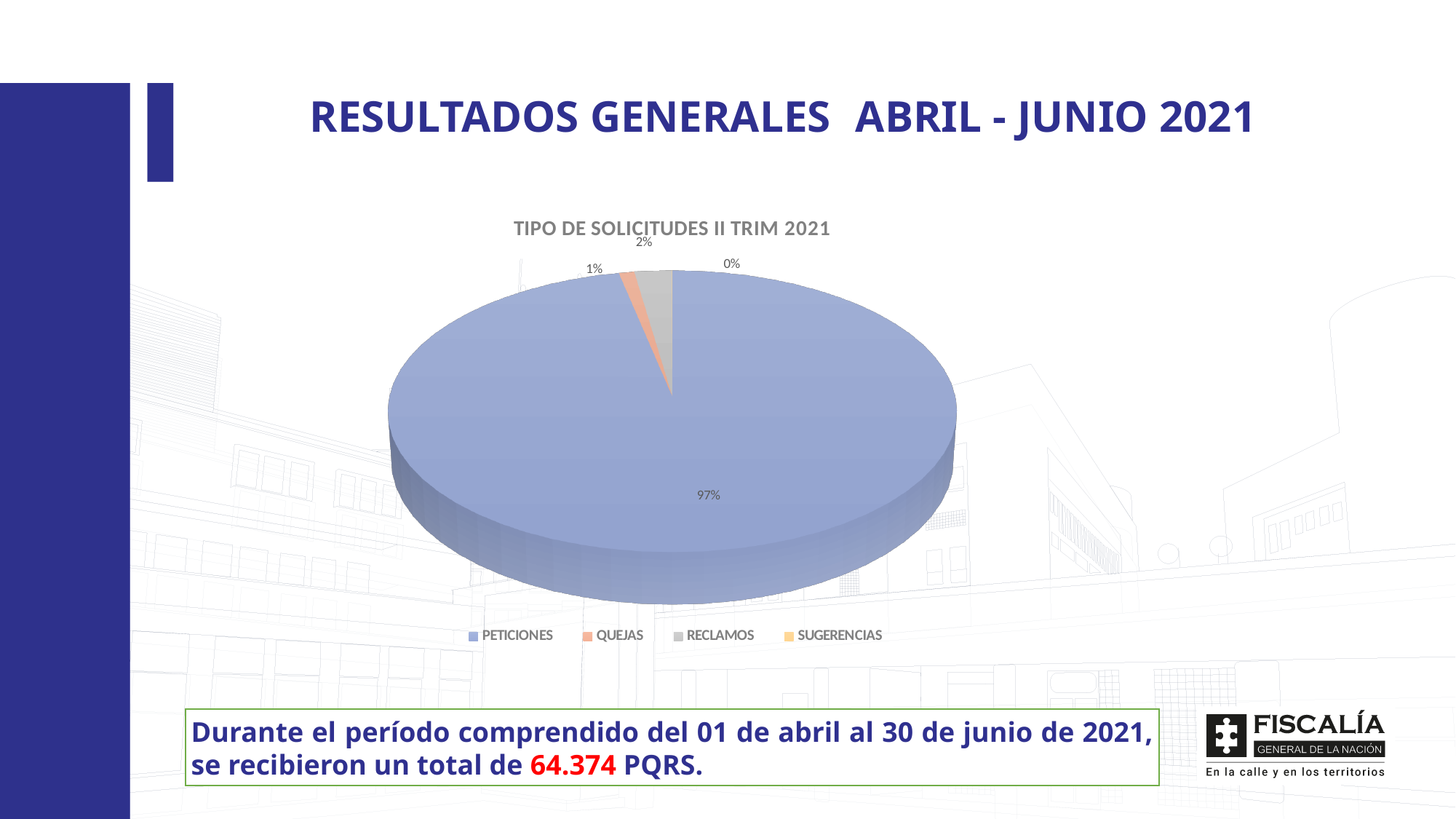
What colour is the PETICIONES slice in the pie chart? Blue What kind of chart is shown on the slide? Pie chart What percentage is shown for SUGERENCIAS? 0% What share of the pie does PETICIONES represent? 97% What is the title of the chart? TIPO DE SOLICITUDES II TRIM 2021 What percentage is shown for QUEJAS? 1% How many categories does the legend list? 4 Which category has the smallest share of the pie? SUGERENCIAS What percentage is shown for RECLAMOS? 2% Which category has the largest share of the pie? PETICIONES Which has a larger share, QUEJAS or RECLAMOS? RECLAMOS What is the difference in percentage points between PETICIONES and RECLAMOS? 95